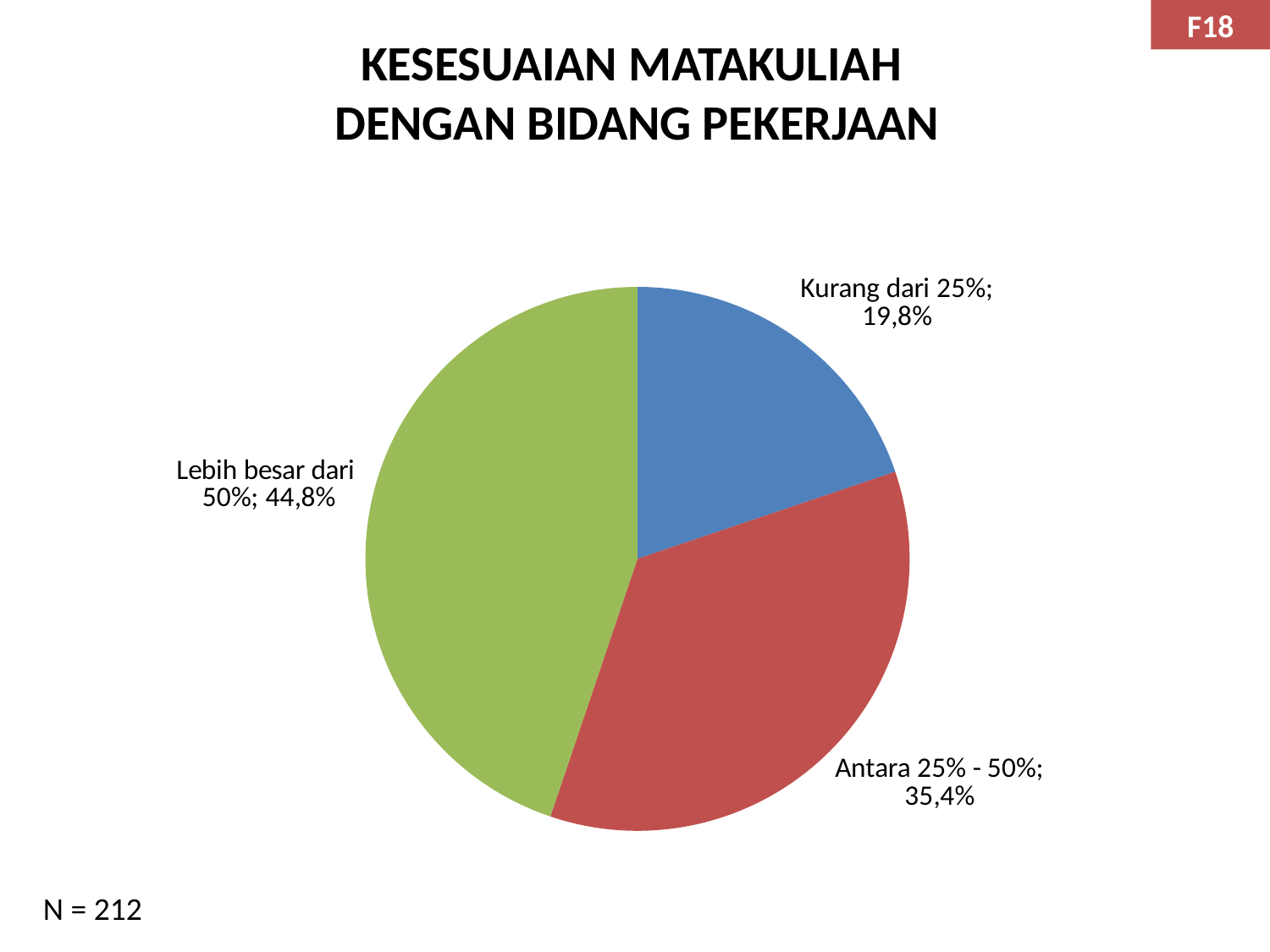
Which is larger: the "Antara 25% - 50%" slice or the "Kurang dari 25%" slice? Antara 25% - 50% Which slice of the pie is the largest? Lebih besar dari 50% What share of the pie is labelled "Lebih besar dari 50%"? 44,8% What is the title of the chart? KESESUAIAN MATAKULIAH DENGAN BIDANG PEKERJAAN Which slice of the pie is the smallest? Kurang dari 25% What kind of chart is shown on the slide? Pie chart What is the difference in percentage points between the "Lebih besar dari 50%" slice and the "Antara 25% - 50%" slice? 9,4 How many slices does the pie chart have? 3 What is the difference in percentage points between the "Antara 25% - 50%" slice and the "Kurang dari 25%" slice? 15,6 What share of the pie is labelled "Antara 25% - 50%"? 35,4% What share of the pie is labelled "Kurang dari 25%"? 19,8% What colour is the "Lebih besar dari 50%" slice? Green